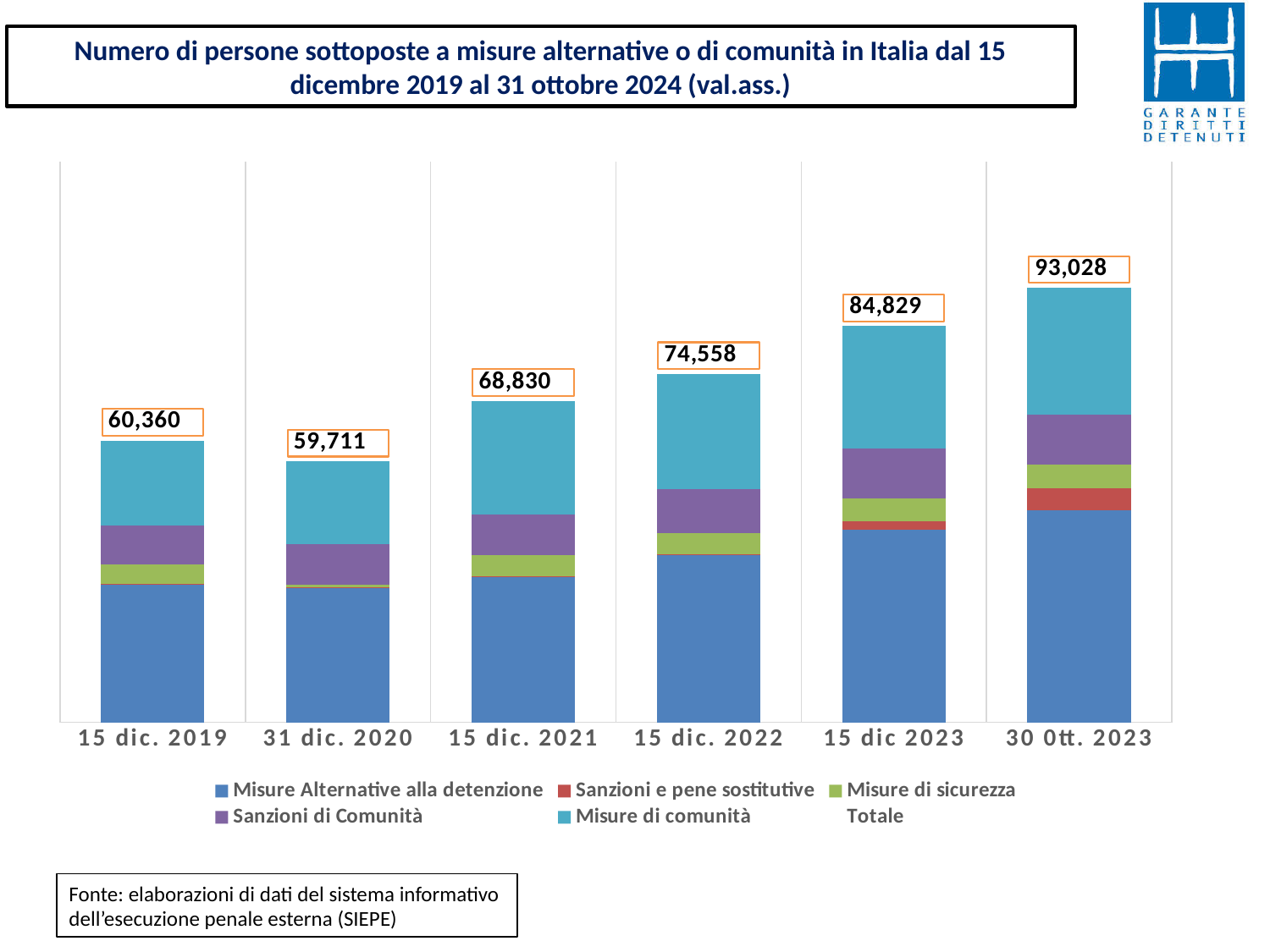
What is the total value labelled on the bar for 30 0tt. 2023? 93,028 By how much does the total for 15 dic. 2019 exceed the total for 31 dic. 2020? 649 What is the difference between the totals for 30 0tt. 2023 and 15 dic 2023? 8,199 Which date has the highest total? 30 0tt. 2023 How many entries does the legend list? 6 Which date has the lowest total? 31 dic. 2020 From 31 dic. 2020 to 30 0tt. 2023, do the totals rise or fall? Rise What kind of chart is shown on the slide? Stacked bar chart What total is shown for 15 dic 2023? 84,829 How many dates (bars) are shown on the x axis? 6 Which has the larger total, 15 dic. 2021 or 15 dic. 2022? 15 dic. 2022 What is the total number of people shown for 15 dic. 2019? 60,360